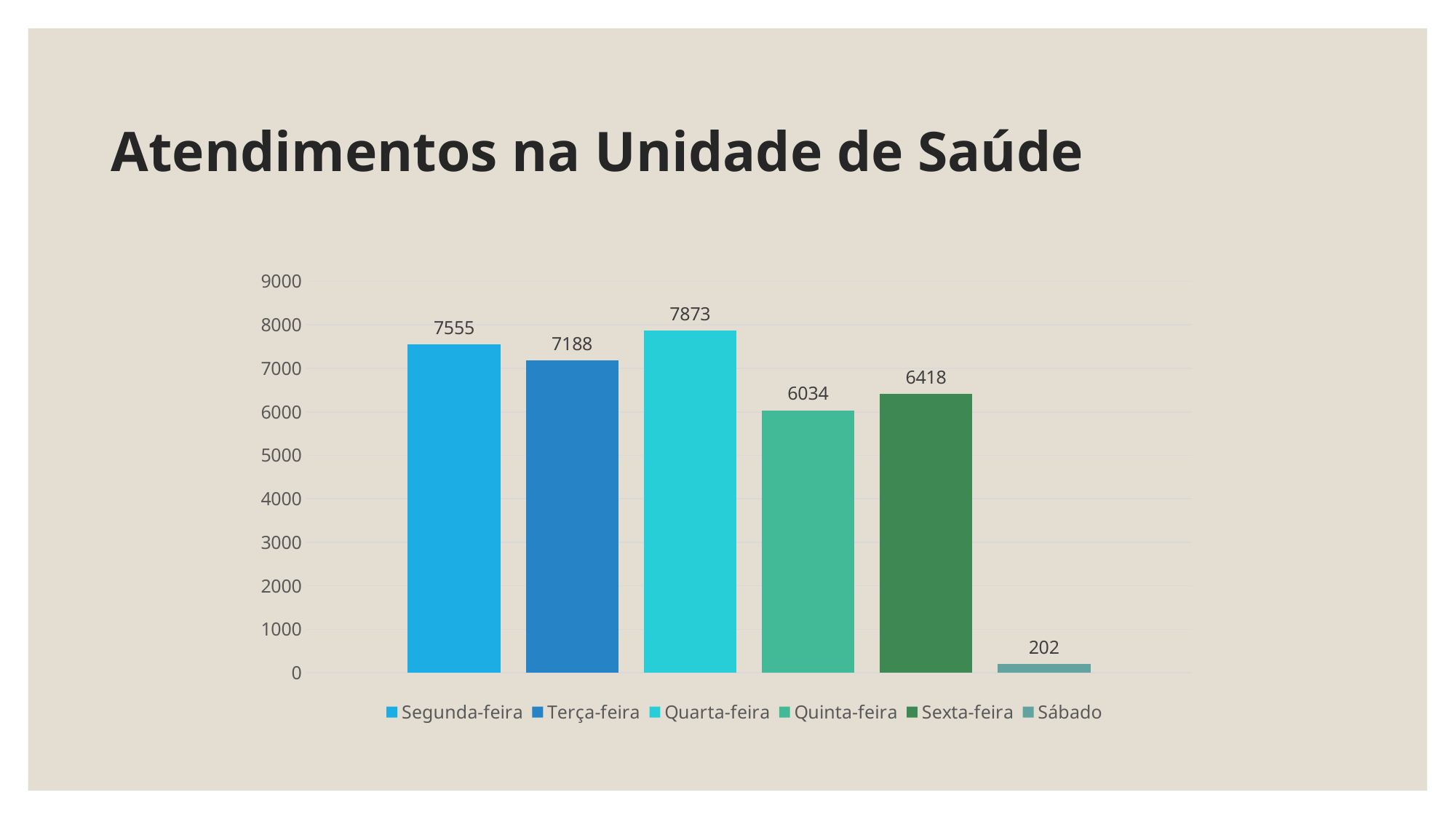
What is the difference between the values for Quarta-feira and Terça-feira? 685 What is the value for Segunda-feira? 7555 How many bars are shown in the chart? 6 Which is larger, the value for Segunda-feira or the value for Terça-feira? Segunda-feira What is the value for Quinta-feira? 6034 What kind of chart is shown on the slide? bar chart Is the value for Sexta-feira greater or less than 7000? less What is the title of the slide? Atendimentos na Unidade de Saúde Which day has the highest value? Quarta-feira Which day has the lowest value? Sábado What is the difference between the values for Sexta-feira and Quinta-feira? 384 What is the value for Sábado? 202